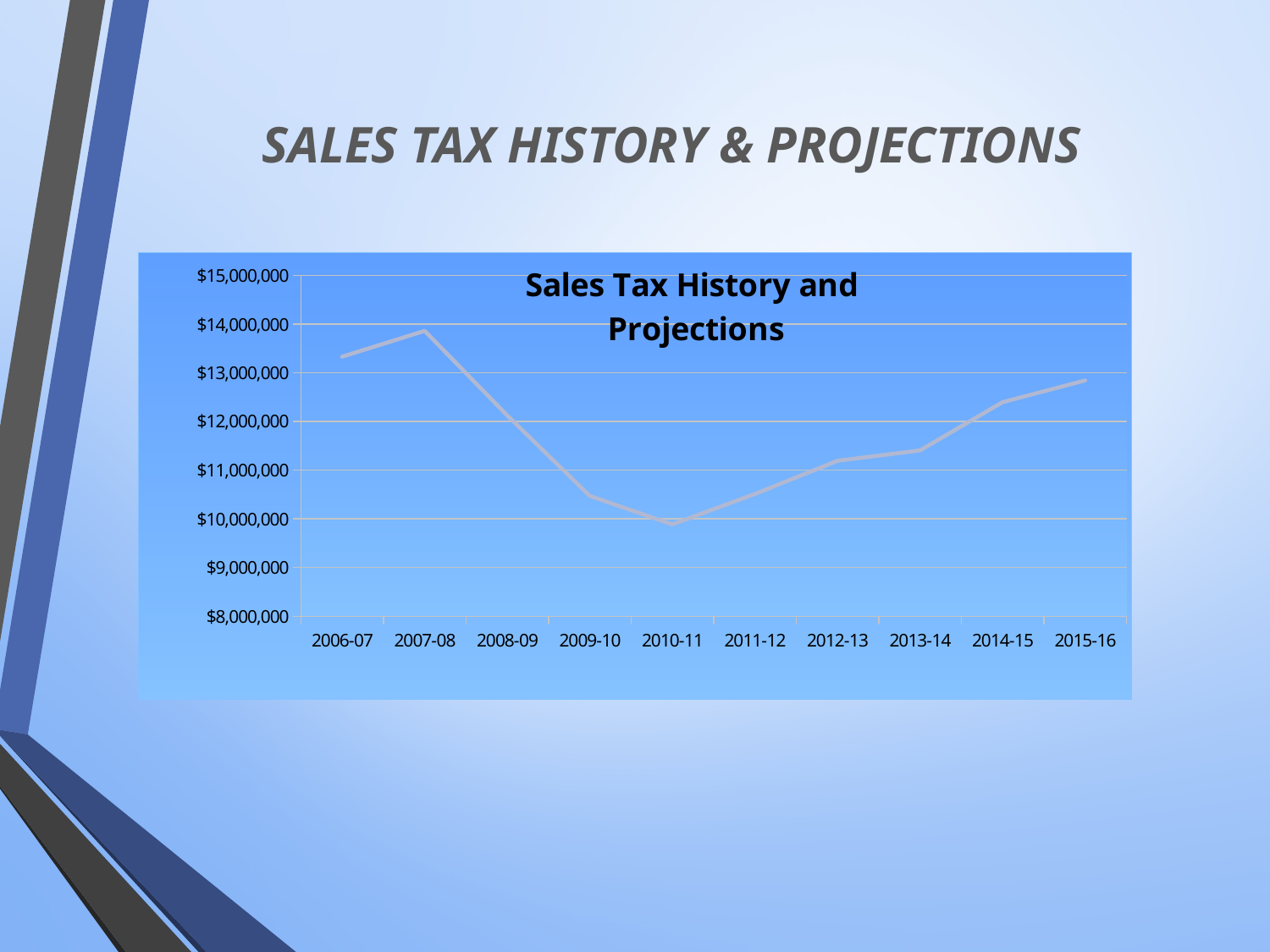
Is the value for 2009-10 greater or less than $11,000,000? less Which is larger, the value for 2006-07 or the value for 2015-16? 2006-07 Which fiscal year has the highest sales tax value in the chart? 2007-08 Which fiscal year has the lowest sales tax value in the chart? 2010-11 Is the value for 2010-11 greater or less than $10,000,000? less Is the value for 2015-16 greater or less than $13,000,000? less Which is larger, the value for 2012-13 or the value for 2009-10? 2012-13 Do the values rise or fall from 2010-11 to 2015-16? rise What is the title shown inside the chart area? Sales Tax History and Projections What kind of chart is shown on the slide? line chart How many fiscal years are plotted on the x axis of the chart? 10